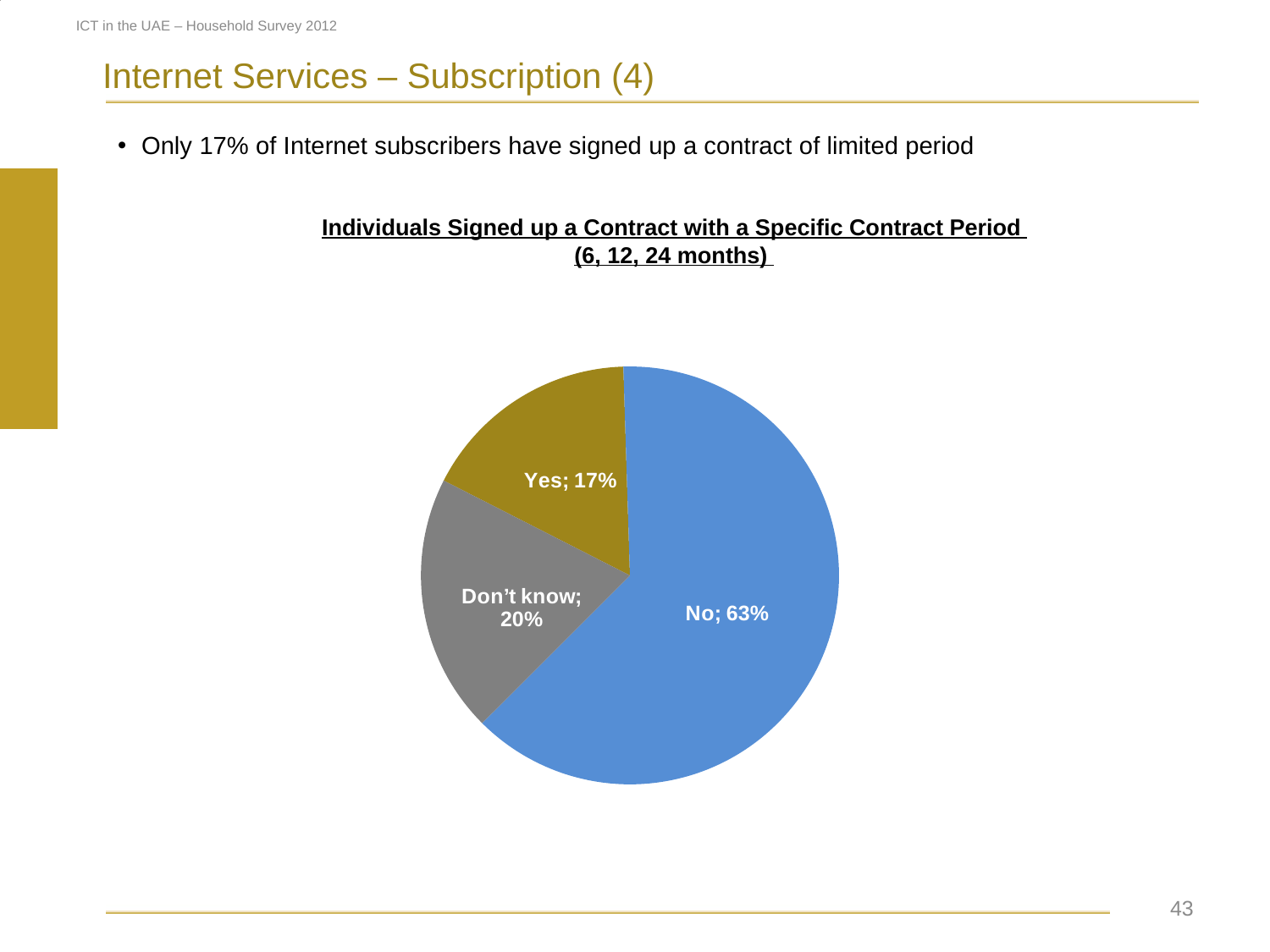
What colour is the "No" slice of the pie chart? blue What is the difference in percentage points between the "No" and "Yes" slices? 46 What percentage of individuals answered "Don't know"? 20% How many slices does the pie chart have? 3 Which response has the largest share of the pie? No What is the difference in percentage points between the "Don't know" and "Yes" slices? 3 Which is larger, the "Don't know" slice or the "Yes" slice? Don't know What percentage of individuals answered "No"? 63% Which response has the smallest share of the pie? Yes What kind of chart is shown on the slide? pie chart What is the title of the pie chart? Individuals Signed up a Contract with a Specific Contract Period (6, 12, 24 months) What percentage of individuals answered "Yes"? 17%